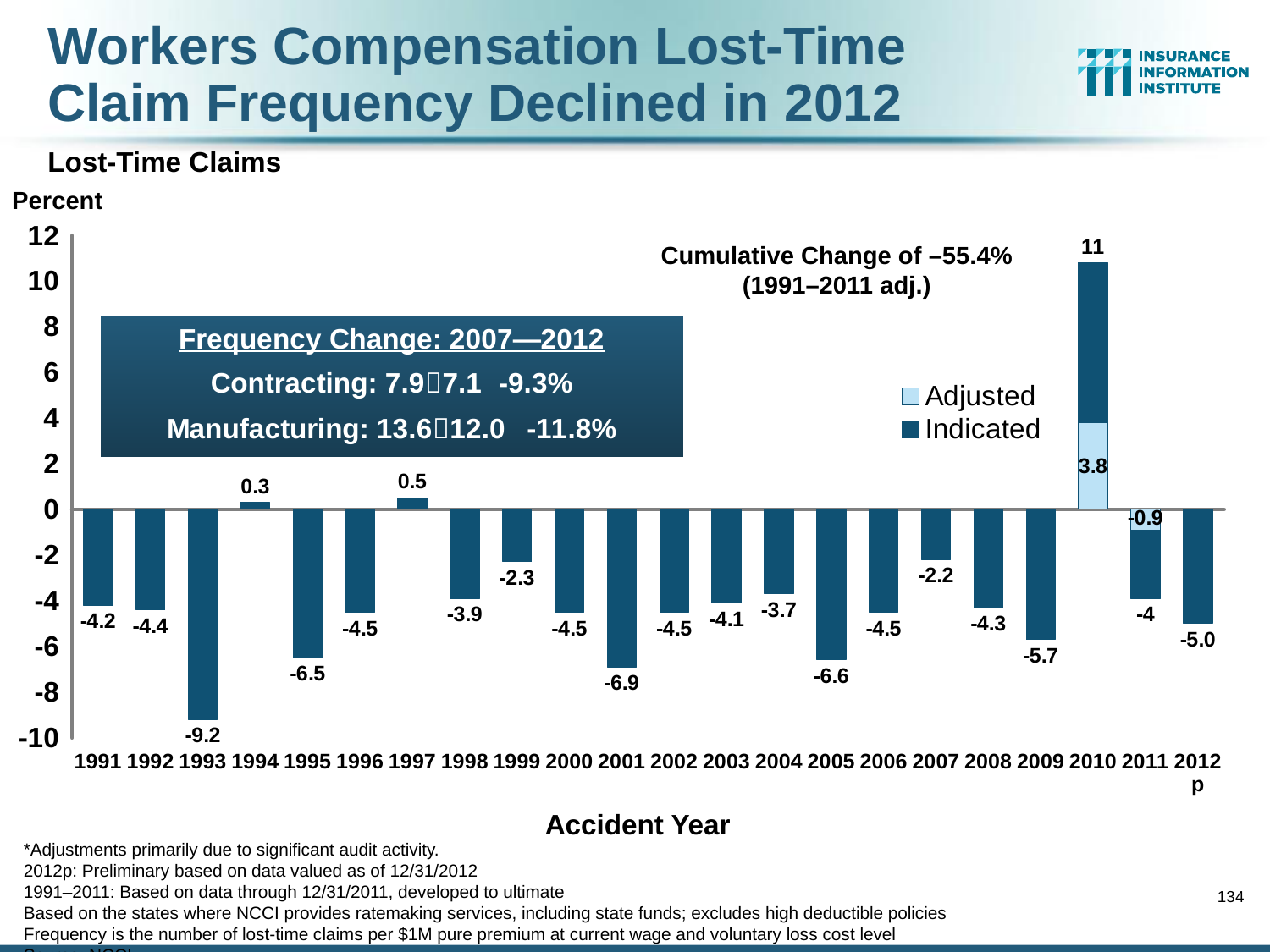
Which is larger, the value for 1994 or the value for 1997? 1997 How many series does the legend list? 2 How many accident years are shown on the x axis? 22 What is the value for 1993? -9.2 Which accident year has the lowest value? 1993 What is the Indicated value for 2010? 11 Which accident year has the highest value? 2010 Is the value for 2001 greater or less than -6? less What is the Adjusted value for 2010? 3.8 What kind of chart is shown? bar chart What is the value for 2012p? -5.0 What is the difference between the values for 2001 and 2005? 0.3